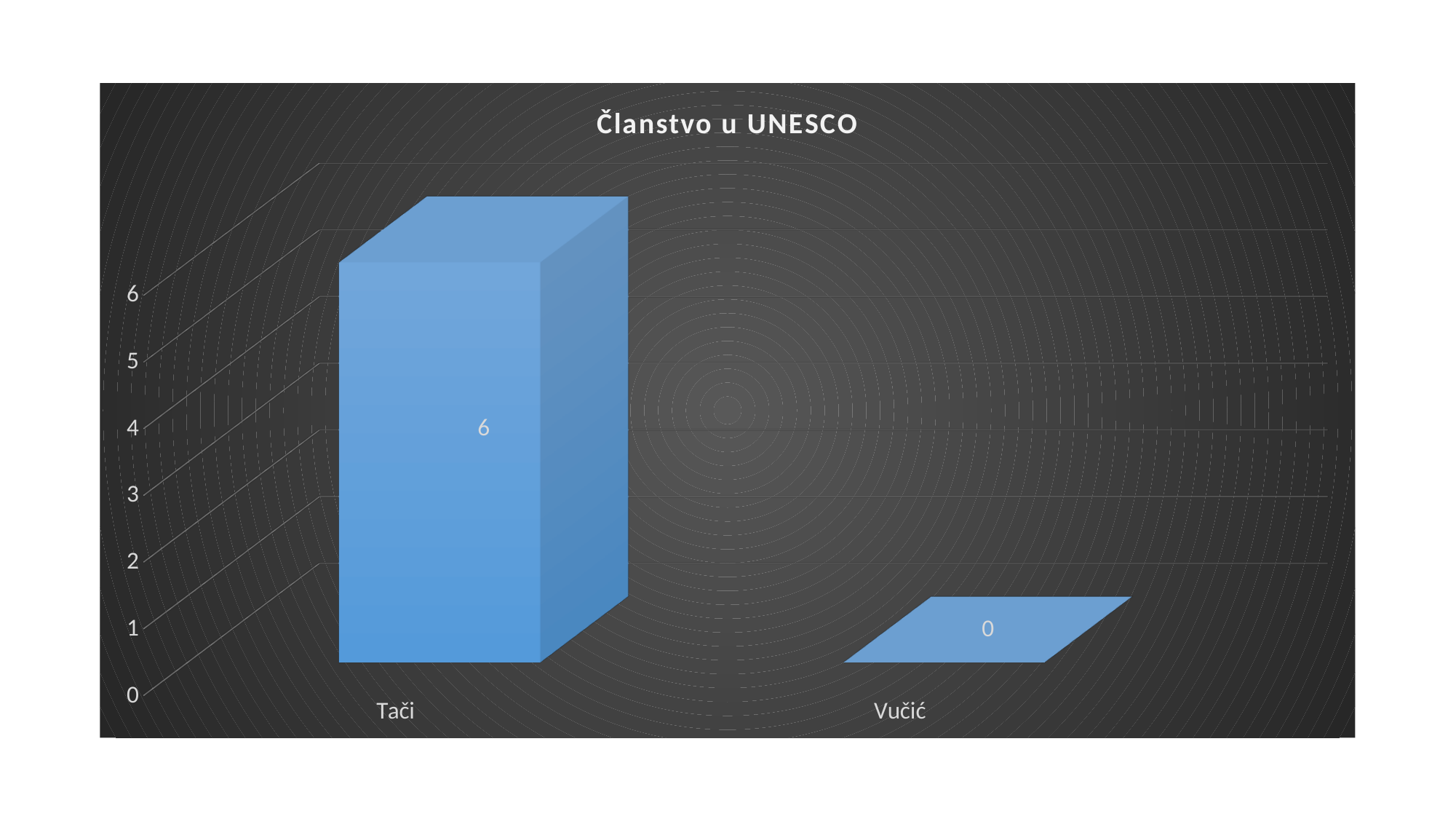
Which category has the lowest value? Vučić Is the value for Tači greater or less than 3? greater Which is larger, the value for Tači or the value for Vučić? Tači What is the difference between the values for Tači and Vučić? 6 What is the title of the chart? Članstvo u UNESCO What is the value for Tači? 6 How many categories are shown on the x axis? 2 Which category has the highest value? Tači What is the highest value shown on the vertical axis? 6 What kind of chart is shown on the slide? bar chart What is the value for Vučić? 0